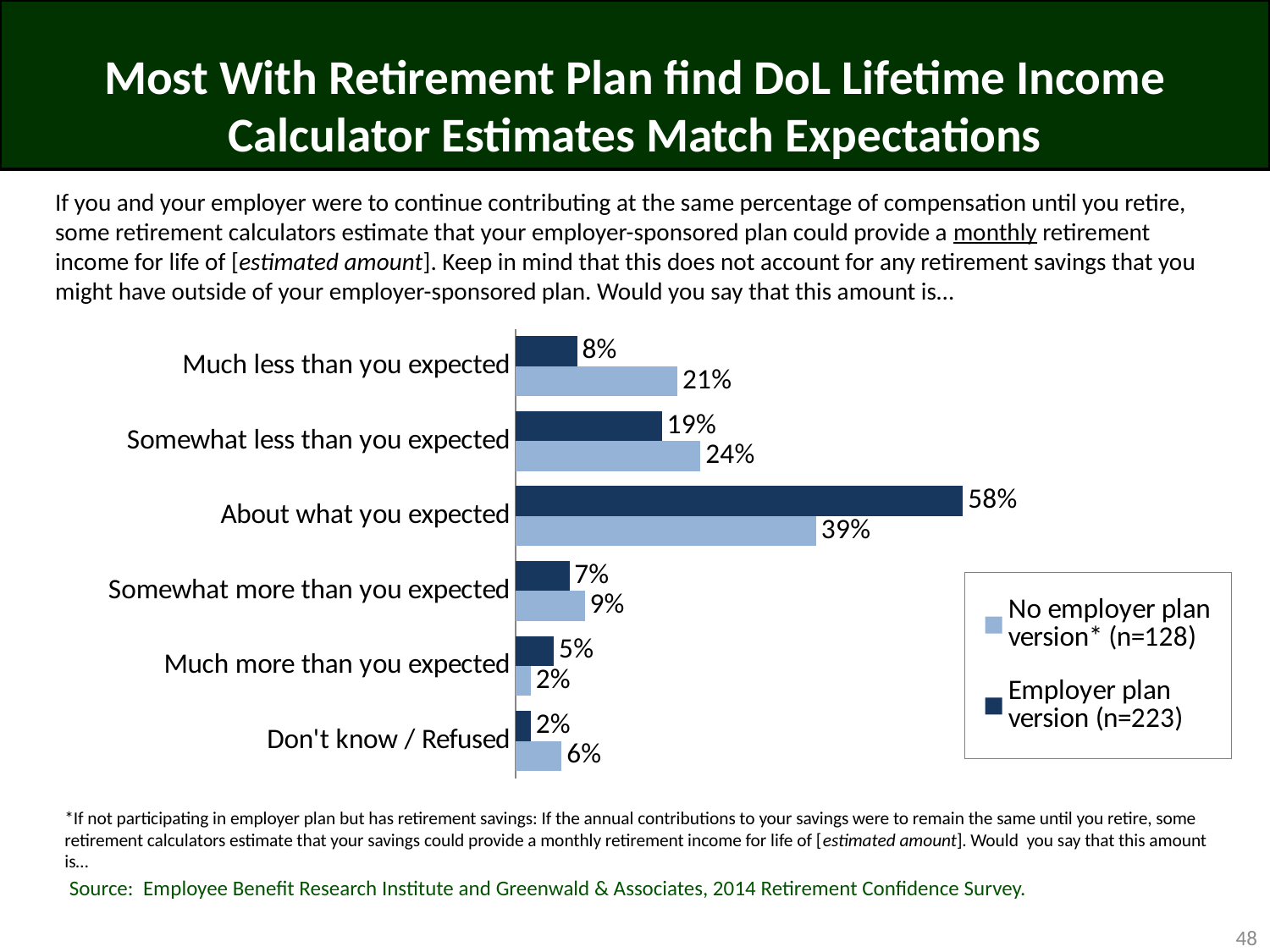
What percentage of the Employer plan version respondents said the amount was about what they expected? 58% What is the value for 'Don't know / Refused' in the Employer plan version series? 2% Which response category has the highest value for the Employer plan version series? About what you expected What type of chart is shown on the slide? Bar chart What percentage of the No employer plan version respondents said the amount was much less than they expected? 21% How many series does the legend list? 2 For 'Much less than you expected', which series has the larger value: Employer plan version or No employer plan version? No employer plan version Which series is shown in dark blue according to the legend? Employer plan version (n=223) What is the value for 'Somewhat less than you expected' in the No employer plan version series? 24% What is the difference between the Employer plan version and No employer plan version values for 'About what you expected'? 19 percentage points Which response category has the lowest value for the No employer plan version series? Much more than you expected How many response categories are shown on the chart? 6